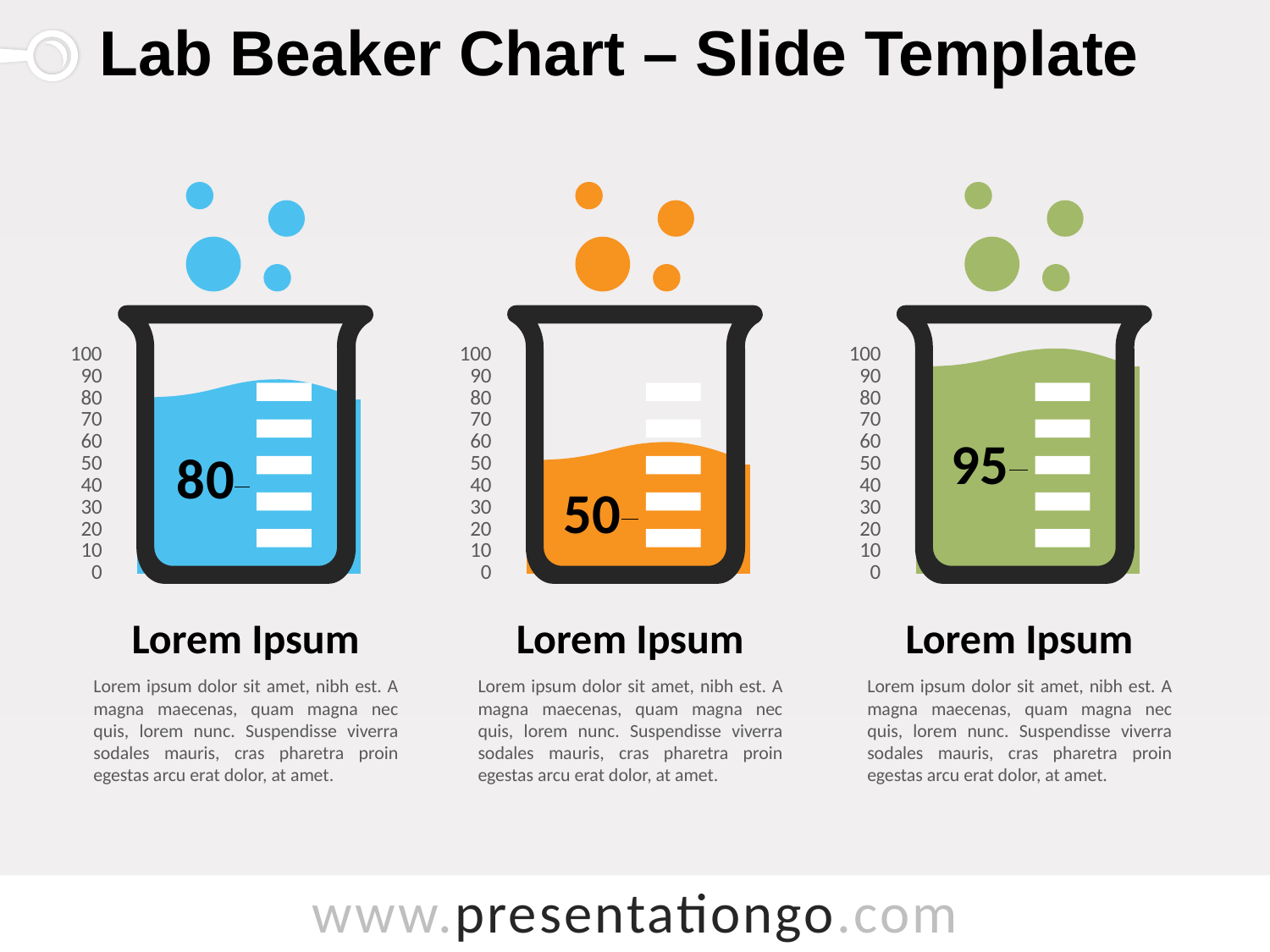
Is the value in the middle beaker greater or less than 60? less What value is shown in the left (blue) beaker chart? 80 What is the difference between the value in the left beaker and the value in the middle beaker? 30 What is the difference between the value in the right beaker and the value in the middle beaker? 45 What is the maximum value on the scale beside each beaker? 100 How many beaker charts are shown on the slide? 3 Which beaker chart shows the highest value: left, middle or right? right What colour is the liquid in the middle beaker? orange What value is shown in the middle (orange) beaker chart? 50 Which is larger, the value in the left beaker or the value in the right beaker? right beaker What value is shown in the right (green) beaker chart? 95 Which beaker chart shows the lowest value: left, middle or right? middle